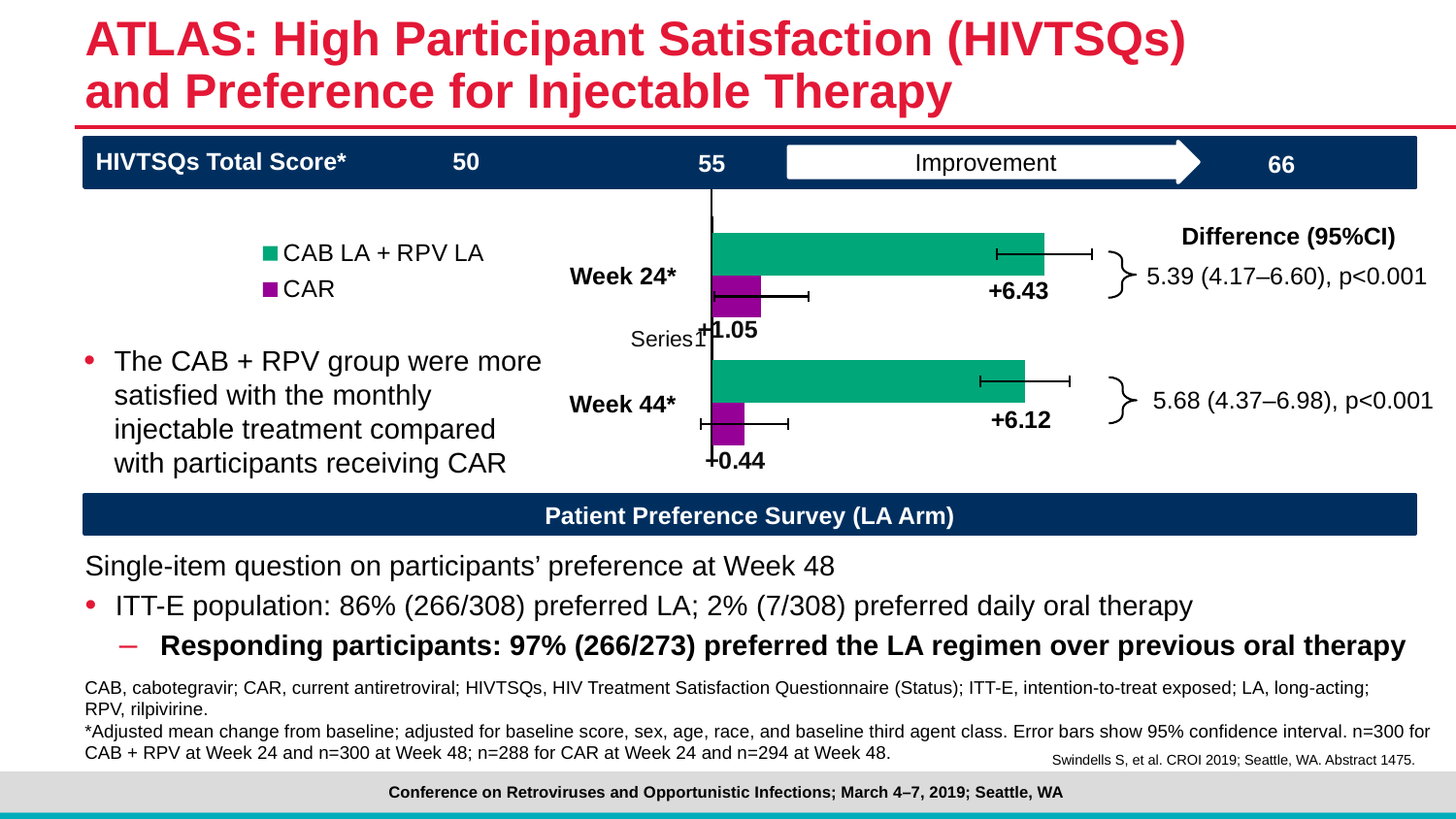
What is the value for CAB LA + RPV LA at Week 44*? +6.12 Which bar has the lowest value in the chart? CAR at Week 44* What colour are the CAB LA + RPV LA bars? green How many series does the legend list? 2 Which series has the larger value at Week 44*, CAB LA + RPV LA or CAR? CAB LA + RPV LA At which week is the CAB LA + RPV LA value highest? Week 24* What kind of chart is shown on the slide? bar chart What is the value for CAB LA + RPV LA at Week 24*? +6.43 What is the value for CAR at Week 44*? +0.44 What is the value for CAR at Week 24*? +1.05 How many week categories are plotted in the chart? 2 Does the CAR value rise or fall from Week 24* to Week 44*? fall